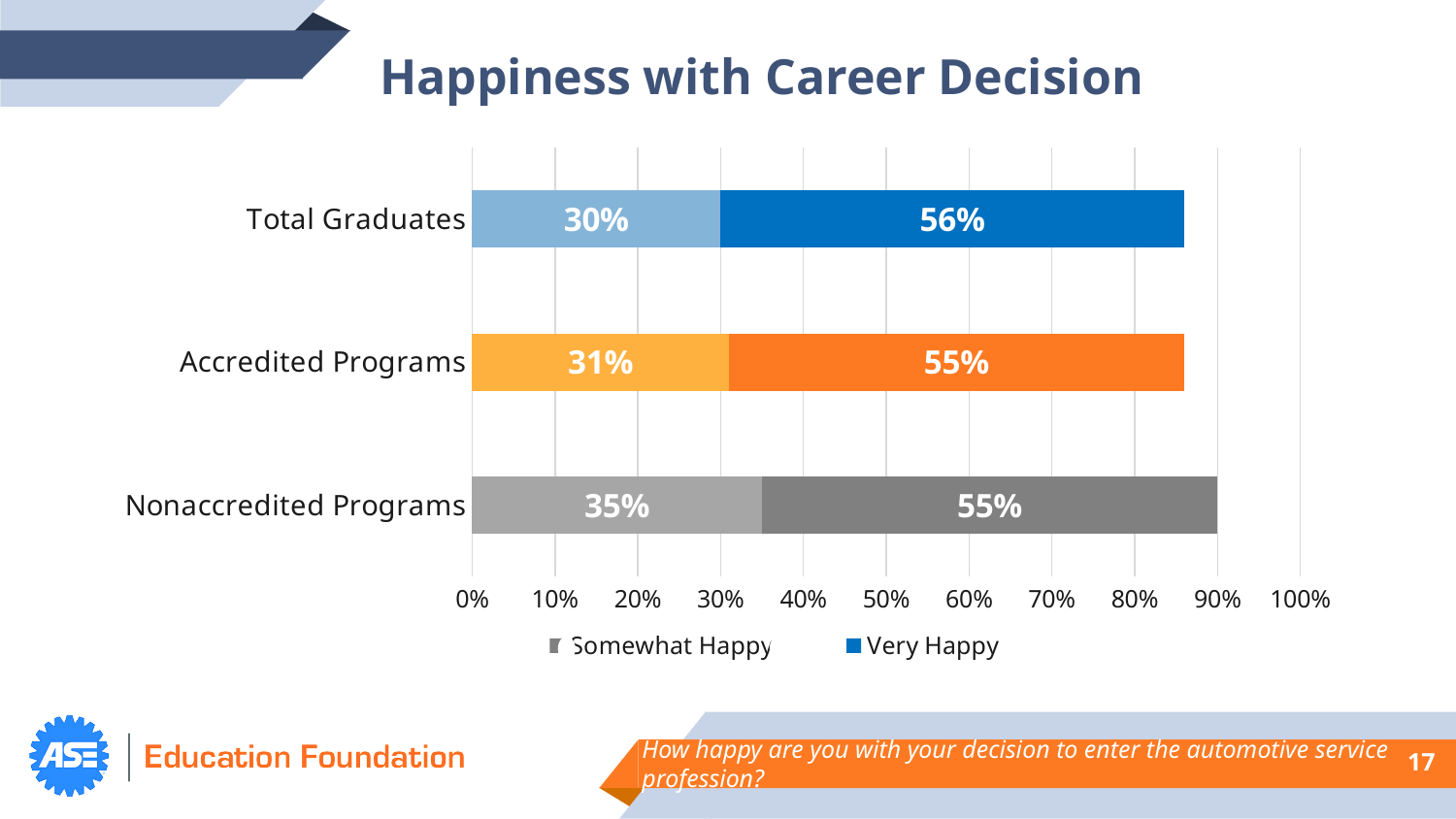
How many series does the legend list? 2 What is the Somewhat Happy value for Total Graduates? 30% How many categories are shown on the chart? 3 What is the difference between the Somewhat Happy values for Nonaccredited Programs and Total Graduates? 5% What type of chart is shown on the slide? Stacked bar chart What is the combined total of the Somewhat Happy and Very Happy segments for Total Graduates? 86% Which category has the highest Somewhat Happy value? Nonaccredited Programs What is the combined total of the Somewhat Happy and Very Happy segments for Nonaccredited Programs? 90% What is the Very Happy value for Accredited Programs? 55% What is the Somewhat Happy value for Nonaccredited Programs? 35% Is the Very Happy value for Total Graduates larger or smaller than the Very Happy value for Accredited Programs? larger Which category has the lowest Somewhat Happy value? Total Graduates